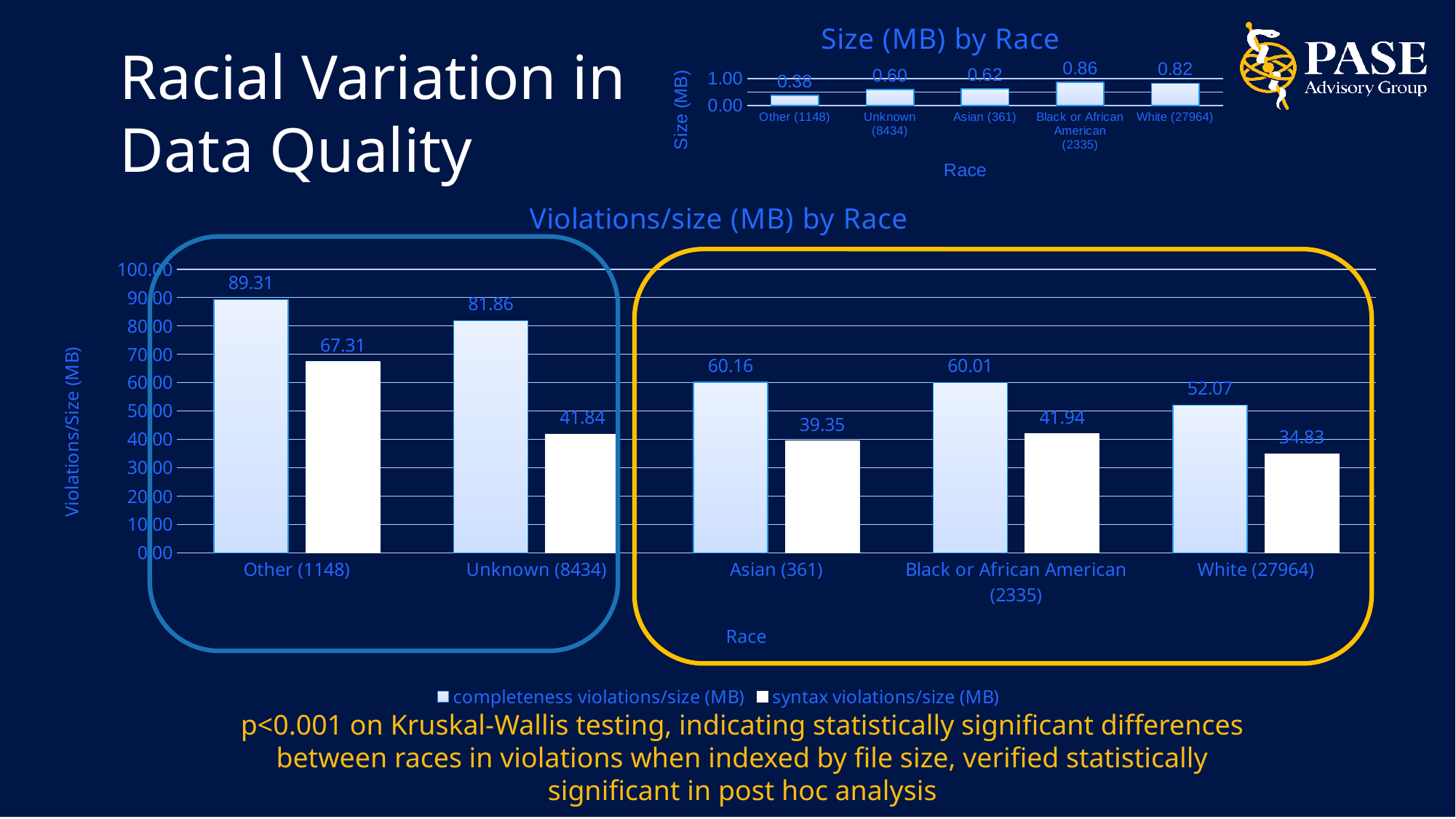
In the 'Violations/size (MB) by Race' chart, what is the syntax violations/size (MB) value for White (27964)? 34.83 In the 'Violations/size (MB) by Race' chart, which is larger: the syntax violations/size (MB) for Asian (361) or for Black or African American (2335)? Black or African American (2335) In the 'Size (MB) by Race' chart, which race has the lowest size (MB)? Other (1148) In the 'Size (MB) by Race' chart, what is the value for Black or African American (2335)? 0.86 How many race categories are shown on the x axis of the 'Violations/size (MB) by Race' chart? 5 In the 'Violations/size (MB) by Race' chart, which race has the lowest syntax violations/size (MB)? White (27964) In the 'Violations/size (MB) by Race' chart, what is the difference between the completeness and syntax violations/size (MB) values for Unknown (8434)? 40.02 In the 'Violations/size (MB) by Race' chart, what is the completeness violations/size (MB) value for Other (1148)? 89.31 How many series does the legend of the 'Violations/size (MB) by Race' chart list? 2 In the 'Size (MB) by Race' chart, what is the difference between the values for White (27964) and Other (1148)? 0.44 What kind of chart is 'Violations/size (MB) by Race'? Bar chart In the 'Violations/size (MB) by Race' chart, which race has the highest completeness violations/size (MB)? Other (1148)